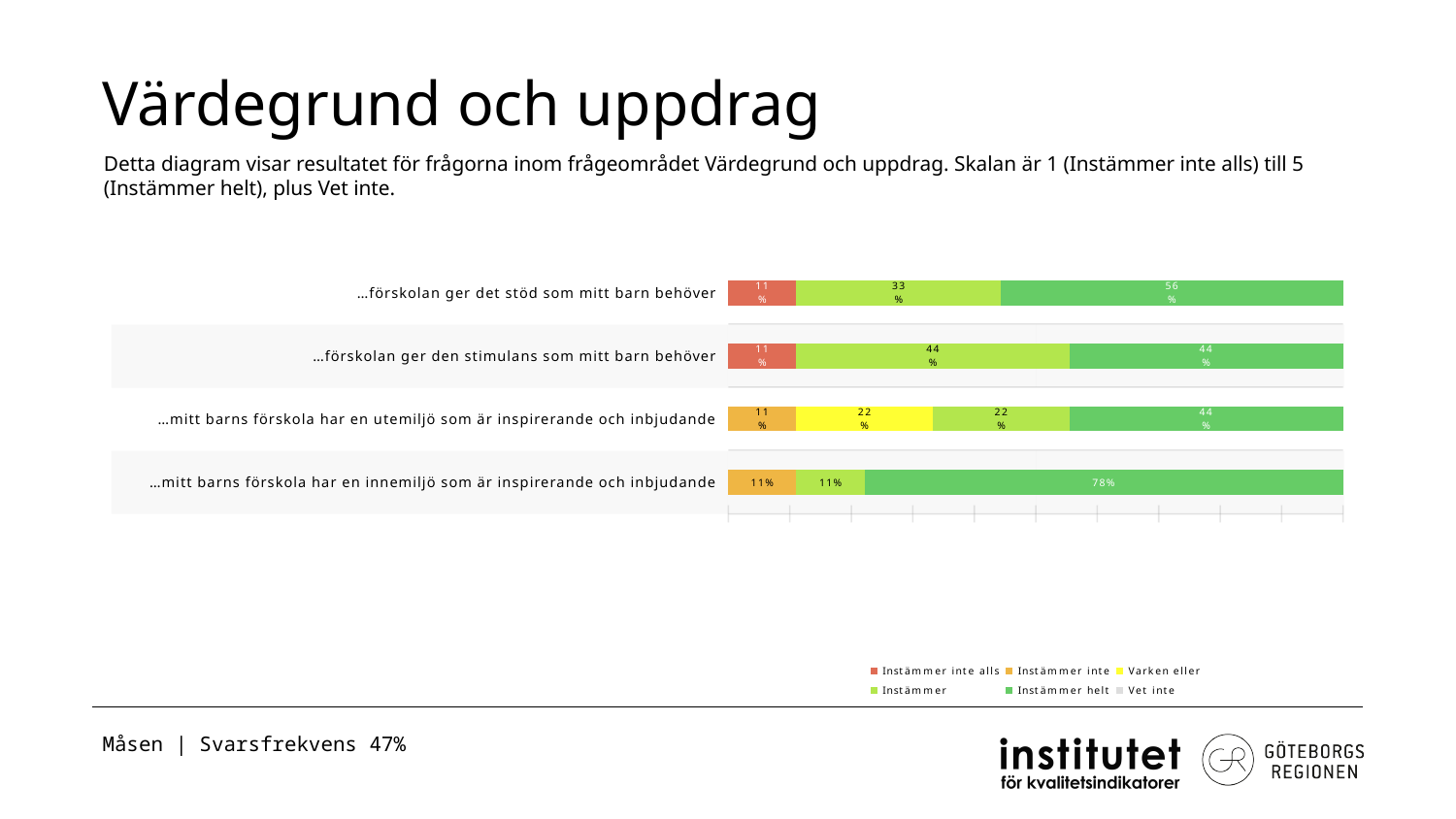
How many series does the legend list? 6 What is the total of the labelled segments for '…förskolan ger det stöd som mitt barn behöver'? 100% What is the difference in 'Instämmer helt' share between the innemiljö statement (78%) and the utemiljö statement (44%)? 34 percentage points How many statements (categories) are plotted in the chart? 4 What is the 'Varken eller' share for '…mitt barns förskola har en utemiljö som är inspirerande och inbjudande'? 22% Which statement has the highest 'Instämmer helt' share? …mitt barns förskola har en innemiljö som är inspirerande och inbjudande What is the 'Instämmer' share for '…förskolan ger den stimulans som mitt barn behöver'? 44% What is the 'Instämmer helt' share for '…förskolan ger det stöd som mitt barn behöver'? 56% What is the 'Instämmer helt' share for '…mitt barns förskola har en innemiljö som är inspirerande och inbjudande'? 78% What kind of chart is shown on the slide? Stacked bar chart Which has the larger 'Instämmer helt' share: '…förskolan ger det stöd som mitt barn behöver' or '…förskolan ger den stimulans som mitt barn behöver'? …förskolan ger det stöd som mitt barn behöver What is the title of the slide containing the chart? Värdegrund och uppdrag